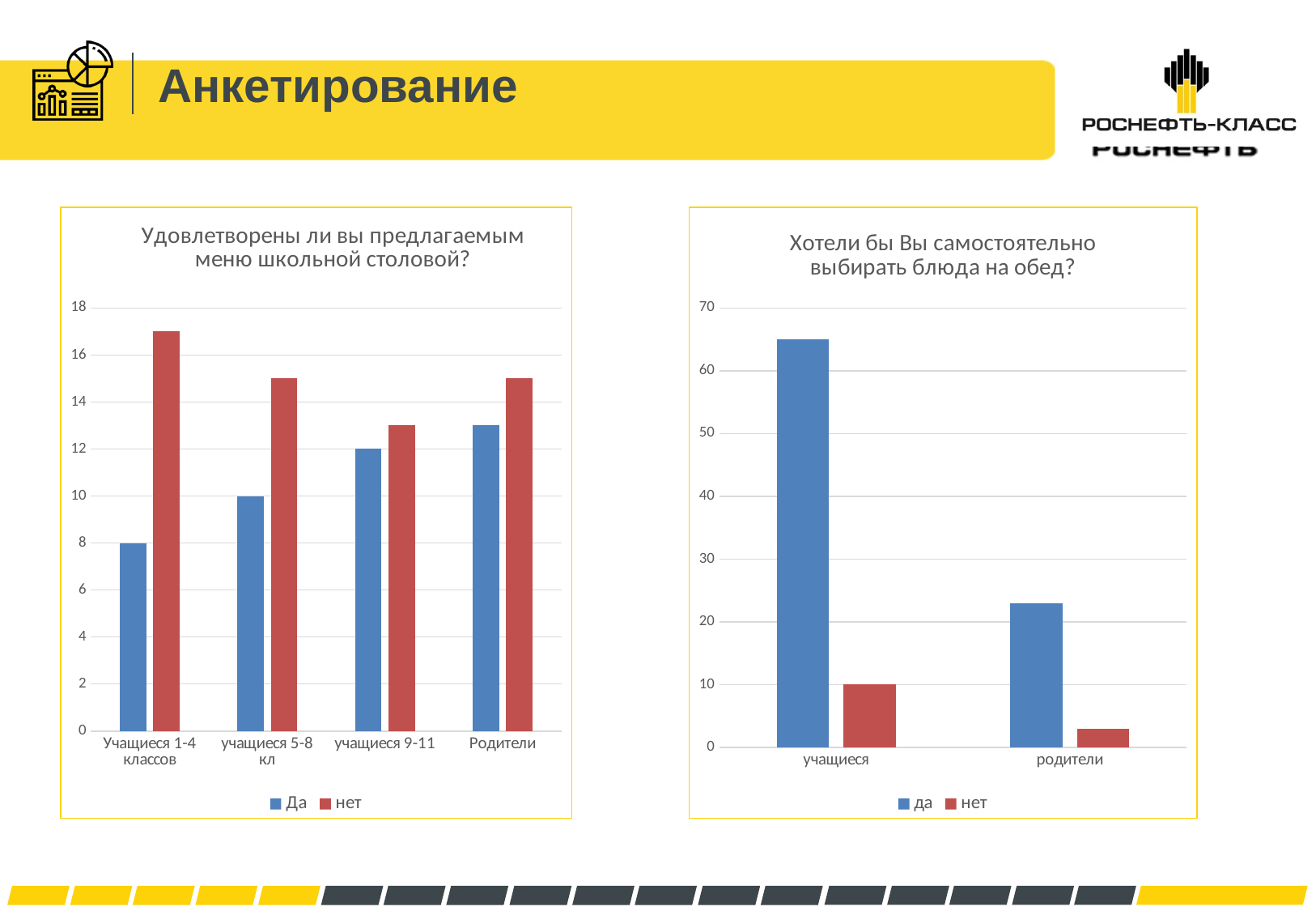
In the left chart 'Удовлетворены ли вы предлагаемым меню школьной столовой?', do the 'Да' values rise or fall from left to right across the categories? rise In the left chart 'Удовлетворены ли вы предлагаемым меню школьной столовой?', what is the 'Да' value for 'учащиеся 5-8 кл'? 10 In the left chart 'Удовлетворены ли вы предлагаемым меню школьной столовой?', is the 'нет' value for 'Учащиеся 1-4 классов' greater or less than 16? greater In the left chart 'Удовлетворены ли вы предлагаемым меню школьной столовой?', how many categories are shown on the x axis? 4 In the right chart 'Хотели бы Вы самостоятельно выбирать блюда на обед?', is the 'да' value for 'учащиеся' greater or less than 60? greater In the left chart 'Удовлетворены ли вы предлагаемым меню школьной столовой?', which category has the highest 'нет' value? Учащиеся 1-4 классов In the left chart 'Удовлетворены ли вы предлагаемым меню школьной столовой?', what is the 'Да' value for 'Учащиеся 1-4 классов'? 8 In the left chart 'Удовлетворены ли вы предлагаемым меню школьной столовой?', what is the 'Да' value for 'учащиеся 9-11'? 12 In the right chart 'Хотели бы Вы самостоятельно выбирать блюда на обед?', what is the 'нет' value for 'учащиеся'? 10 In the left chart 'Удовлетворены ли вы предлагаемым меню школьной столовой?', how many series does the legend list? 2 In the right chart 'Хотели бы Вы самостоятельно выбирать блюда на обед?', which category has the larger 'да' value, 'учащиеся' or 'родители'? учащиеся What kind of chart is the left chart, 'Удовлетворены ли вы предлагаемым меню школьной столовой?'? bar chart